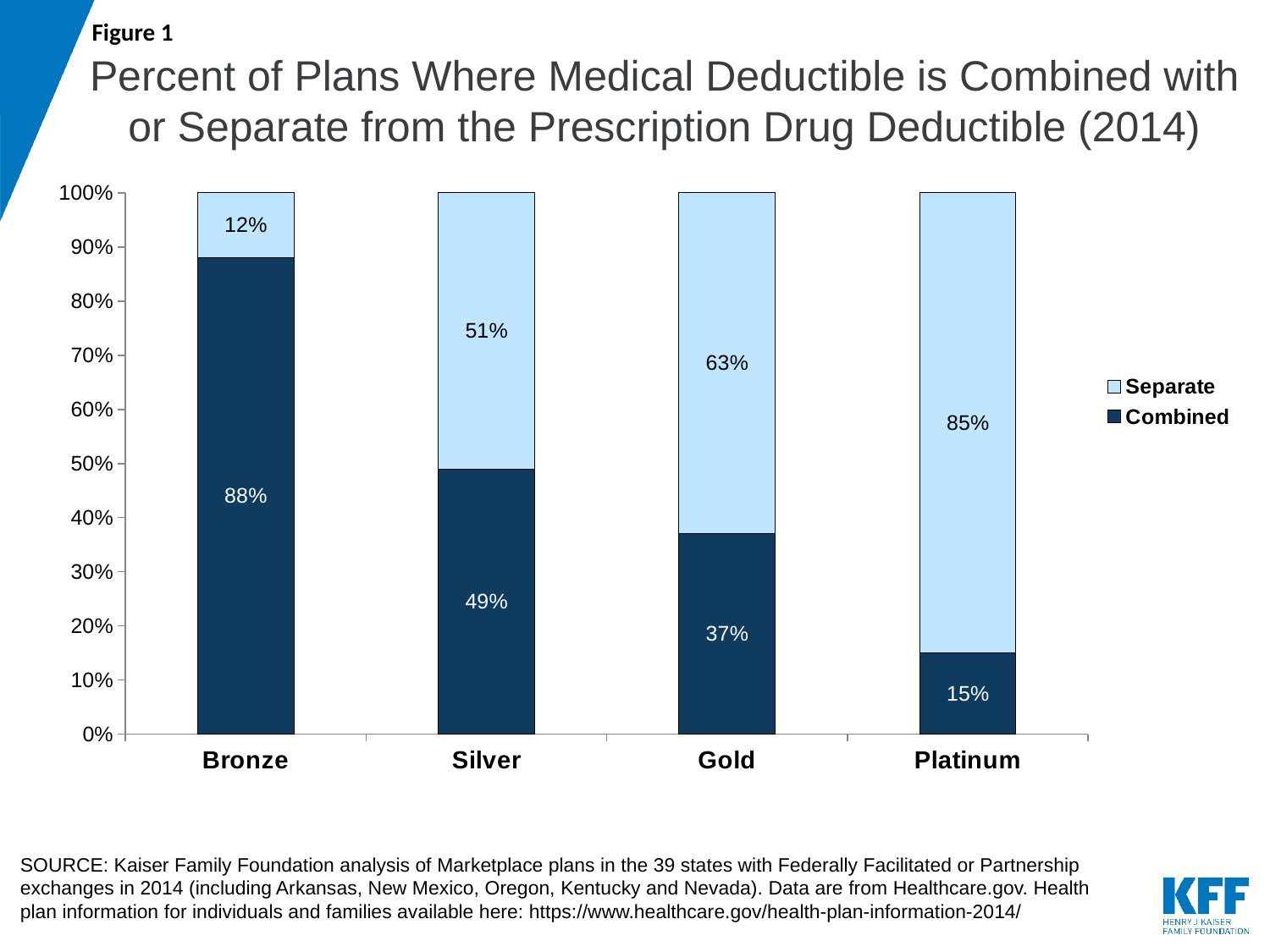
Which is larger: the Combined percentage for Silver or the Combined percentage for Gold? Silver How many series does the legend list? 2 How many plan tiers are shown on the x axis? 4 What percent of Silver plans have a Separate deductible? 51% Does the Combined percentage rise or fall from Bronze to Platinum? Fall Which plan tier has the highest Combined percentage? Bronze What percent of Platinum plans have a Separate deductible? 85% What percent of Bronze plans have a Combined deductible? 88% What is the difference between the Separate percentage for Platinum and the Separate percentage for Gold? 22% What kind of chart is shown on the slide? Stacked bar chart Which plan tier has the lowest Separate percentage? Bronze What percent of Gold plans have a Combined deductible? 37%